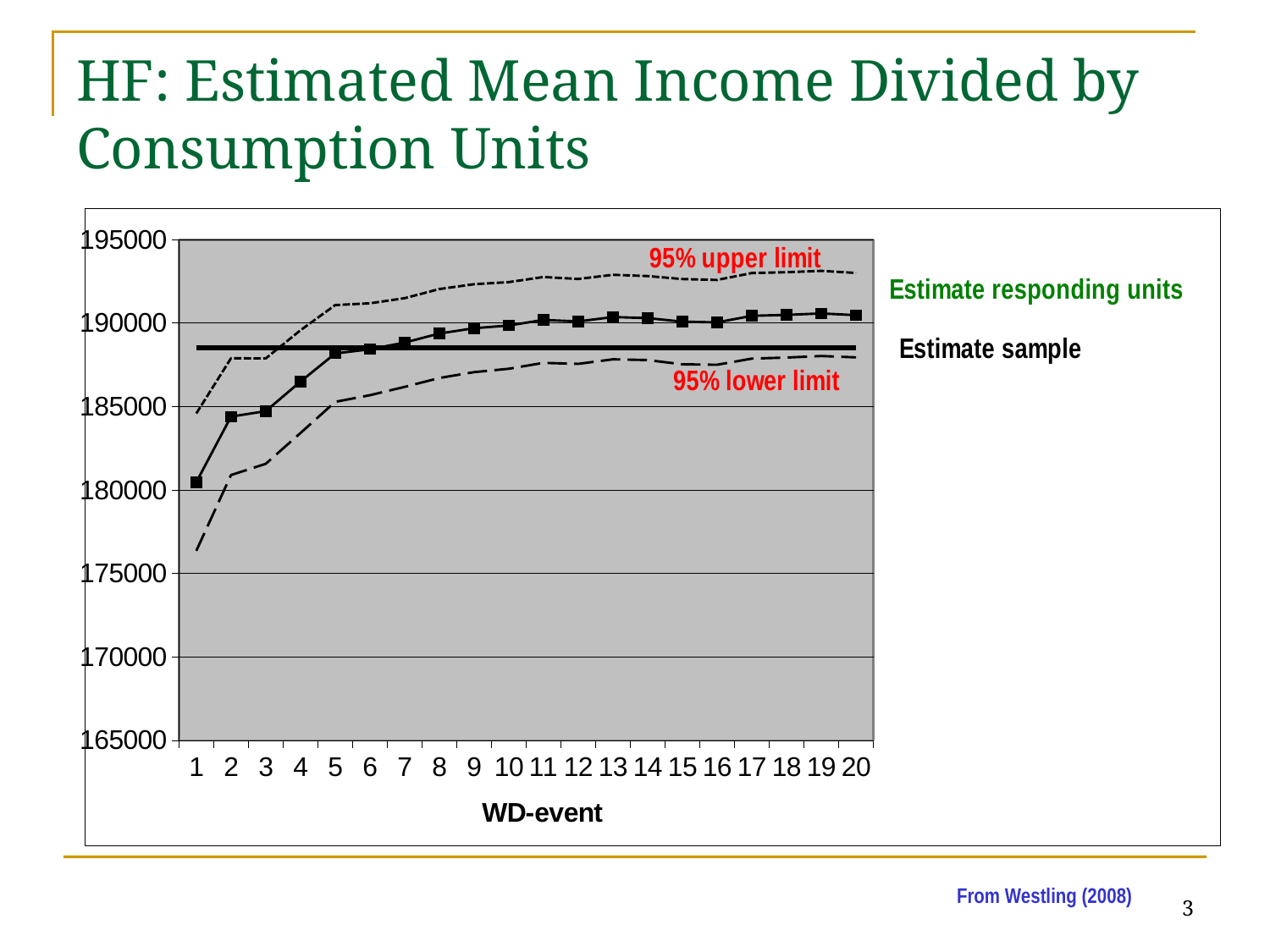
Is the Estimate responding units value at WD-event 1 greater or less than 185000? less Does the Estimate responding units series rise or fall as WD-event increases from 1 to 20? Rises Is the Estimate responding units value at WD-event 20 greater or less than 185000? greater At WD-event 1, is the Estimate responding units value higher or lower than the Estimate sample line? Lower What kind of chart is shown on the slide? Line chart At which WD-event is the Estimate responding units value lowest? 1 Is the Estimate sample line greater or less than 190000? less How many WD-event points are shown on the x axis? 20 What is the label of the x axis? WD-event Which series has the highest value at WD-event 20? 95% upper limit How many series are labelled on the chart? 4